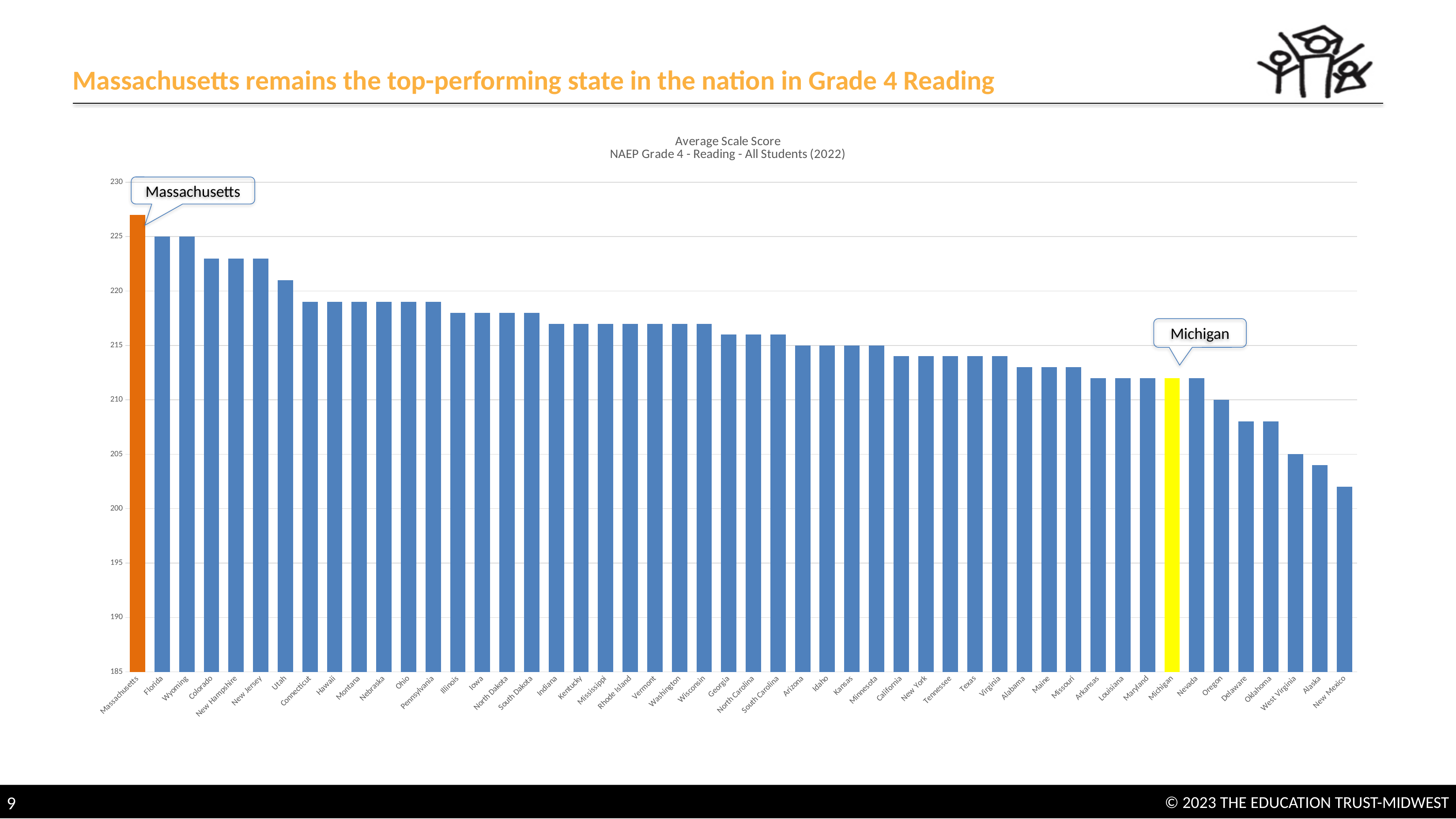
How many states are shown on the x axis of the chart? 50 Which state has the highest average scale score in the chart? Massachusetts What type of chart is shown on the slide? Bar chart Is the average scale score for Utah greater or less than 220? greater Is the average scale score for New Mexico greater or less than 200? greater Is the average scale score for Michigan greater or less than 215? less What colour is the bar for Michigan? Yellow Which state has a higher average scale score, Massachusetts or Florida? Massachusetts Do the bar values rise or fall moving from left to right along the x axis? Fall Which state has the lowest average scale score in the chart? New Mexico Which state has a higher average scale score, Michigan or Oregon? Michigan